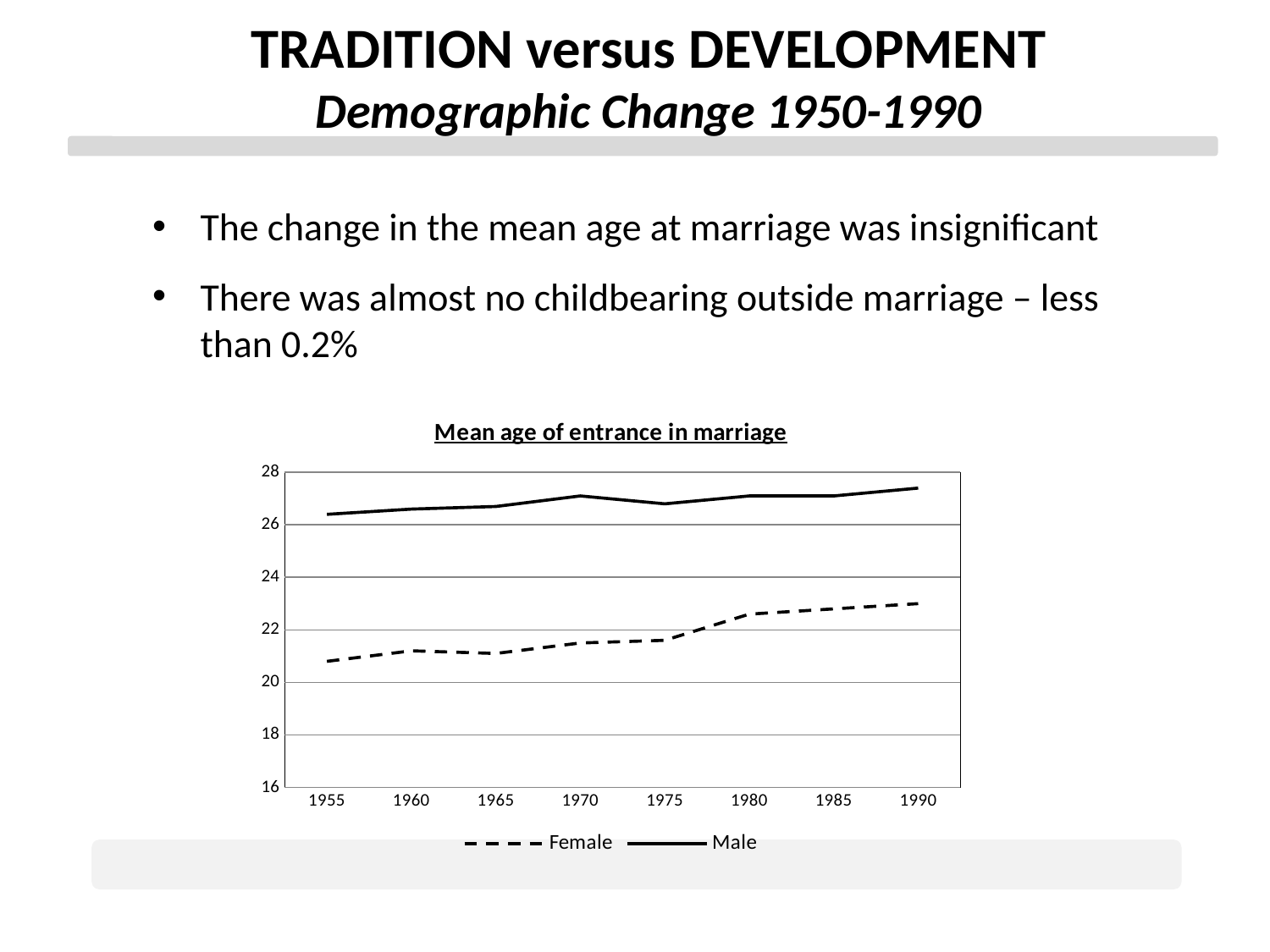
In which year is the Female mean age at marriage lowest? 1955 In 1970, which series has the higher value, Male or Female? Male Is the Female value for 1955 greater or less than 22? less Is the Male value for 1990 greater or less than 26? greater In which year is the Female mean age at marriage highest? 1990 What kind of chart is shown on the slide? line chart Does the Female mean age at marriage rise or fall overall from 1955 to 1990? rise Is the Female value for 1990 greater or less than 22? greater Which series is drawn with a dashed line? Female What is the title of the chart? Mean age of entrance in marriage How many years are plotted along the x axis of the chart? 8 How many series does the chart legend list? 2